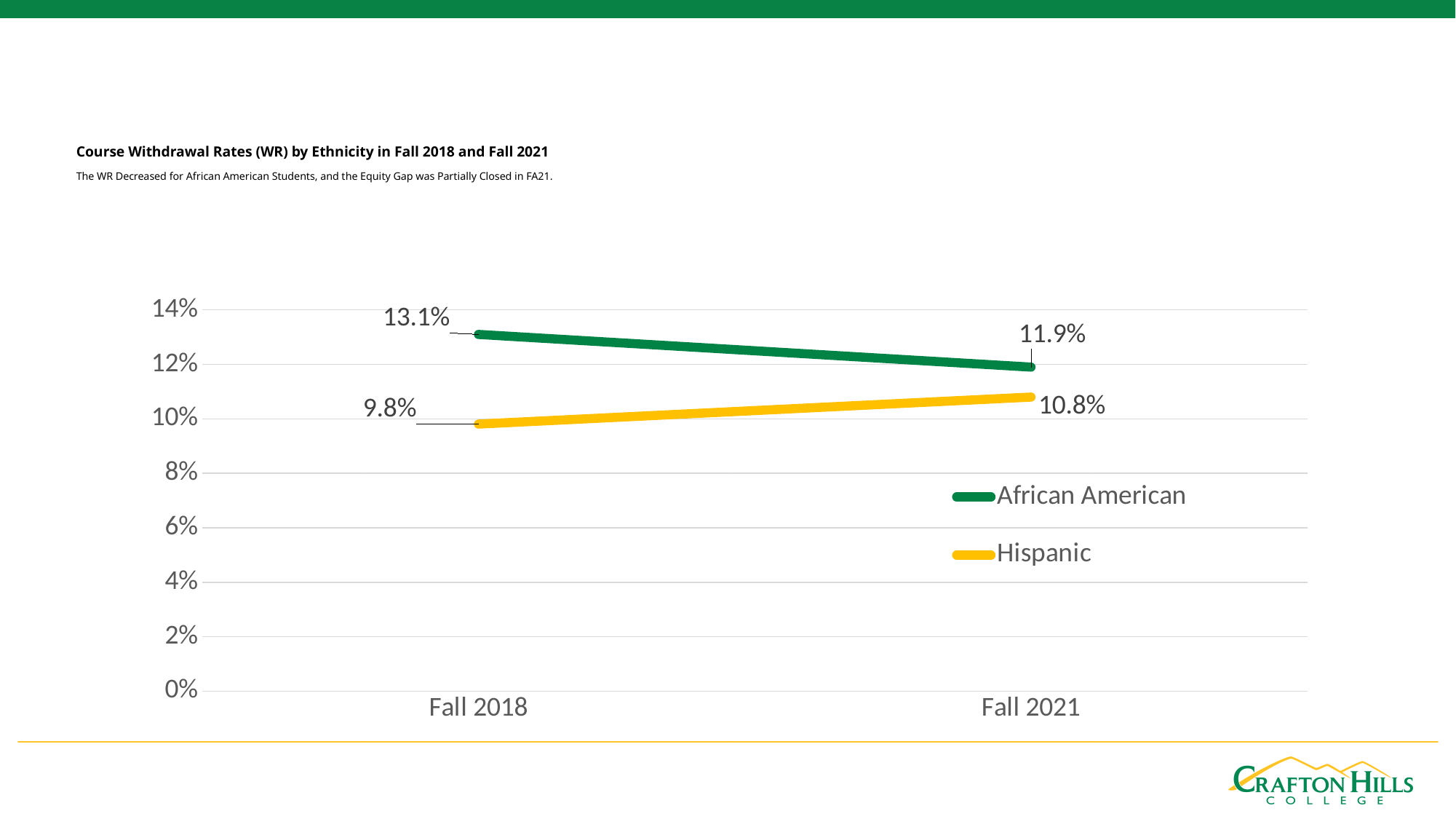
What colour is the line for Hispanic students? Yellow How many series does the legend list? 2 What was the course withdrawal rate for African American students in Fall 2018? 13.1% By how many percentage points did the African American withdrawal rate change from Fall 2018 to Fall 2021? 1.2 percentage points Did the withdrawal rate for Hispanic students rise or fall from Fall 2018 to Fall 2021? Rise What was the course withdrawal rate for African American students in Fall 2021? 11.9% What was the course withdrawal rate for Hispanic students in Fall 2018? 9.8% Did the withdrawal rate for African American students rise or fall from Fall 2018 to Fall 2021? Fall What was the gap between the African American and Hispanic withdrawal rates in Fall 2018? 3.3 percentage points What kind of chart is shown on the slide? Line chart What was the course withdrawal rate for Hispanic students in Fall 2021? 10.8% Which group had the higher withdrawal rate in Fall 2021? African American